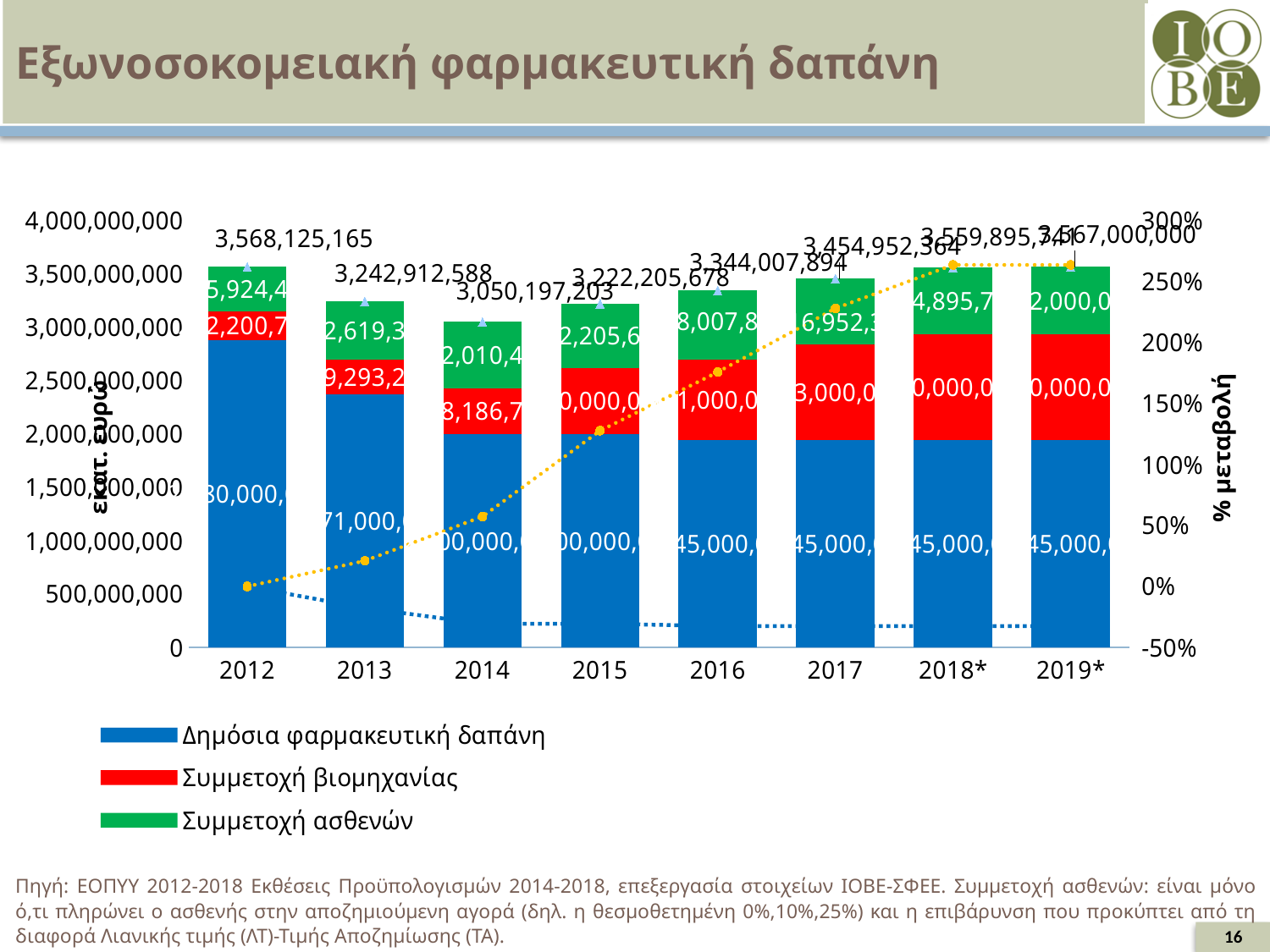
What is the total value labelled above the bar for 2017? 3,454,952,364 How many series does the legend list? 3 Is the value of the Δημόσια φαρμακευτική δαπάνη segment for 2012 greater or less than 2,500,000,000? greater Which year has a larger total expenditure, 2015 or 2016? 2016 What is the total value labelled above the bar for 2015? 3,222,205,678 What is the total outpatient pharmaceutical expenditure shown for 2012? 3,568,125,165 What kind of chart is used to show the expenditure components? Stacked bar chart What is the difference between the total for 2013 and the total for 2014? 192,715,385 Do the total expenditure values rise or fall from 2014 to 2019*? Rise Which year has the lowest total expenditure? 2014 How many years are shown on the x axis? 8 What is the total value labelled above the bar for 2019*? 3,567,000,000